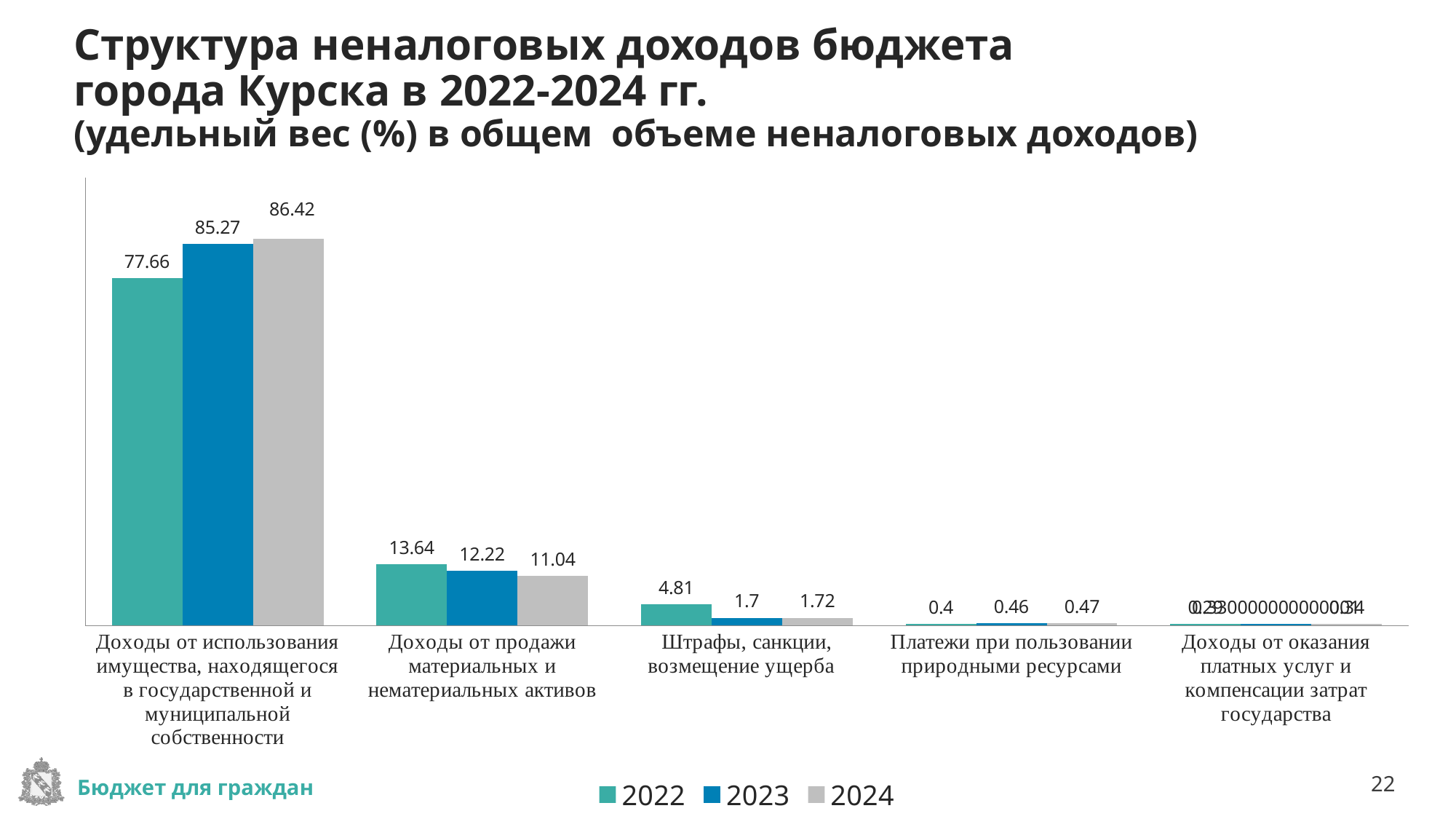
What is the difference between the 2022 and 2023 values in the category "Штрафы, санкции, возмещение ущерба"? 3.11 What kind of chart is shown on the slide? Bar chart What is the value for 2024 in the category "Платежи при пользовании природными ресурсами"? 0.47 What is the value for 2023 in the category "Штрафы, санкции, возмещение ущерба"? 1.7 Which category has the highest value for 2024? Доходы от использования имущества, находящегося в государственной и муниципальной собственности What is the difference between the 2024 and 2022 values in the category "Доходы от использования имущества, находящегося в государственной и муниципальной собственности"? 8.76 Which is larger in the category "Доходы от продажи материальных и нематериальных активов": the 2022 value or the 2024 value? 2022 How many series does the legend list? 3 How many categories are shown on the x axis? 5 What is the value for 2024 in the category "Доходы от продажи материальных и нематериальных активов"? 11.04 What is the value for 2022 in the category "Доходы от использования имущества, находящегося в государственной и муниципальной собственности"? 77.66 Which year has the lowest value in the category "Доходы от использования имущества, находящегося в государственной и муниципальной собственности"? 2022